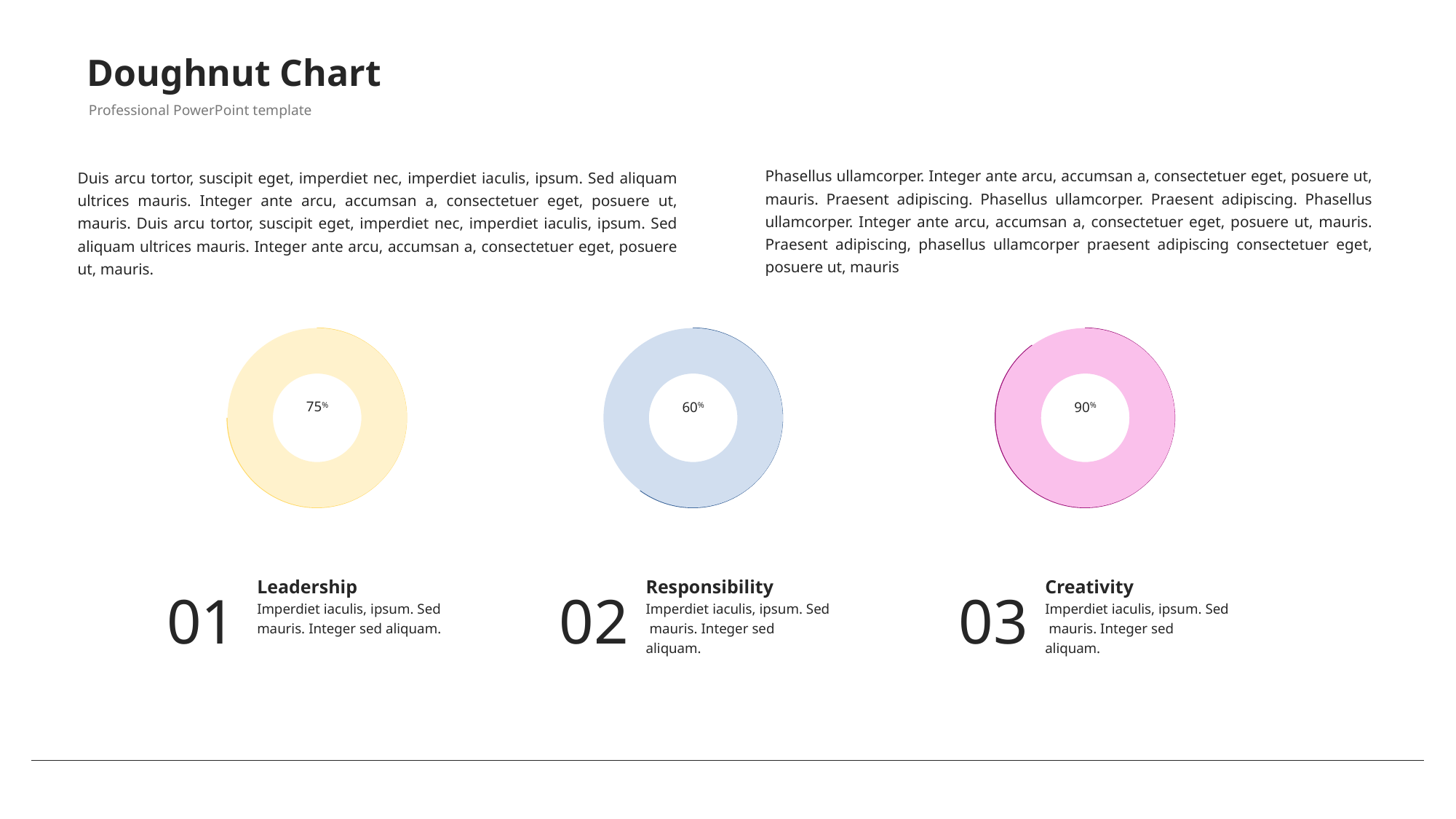
What value is shown in the centre of the left doughnut chart (Leadership)? 75% What value is shown in the centre of the right doughnut chart (Creativity)? 90% What is the difference between the percentage in the left doughnut chart (Leadership) and the middle doughnut chart (Responsibility)? 15% How many doughnut charts are on the slide? 3 What kind of chart is used on this slide? Doughnut chart Which of the three doughnut charts shows the highest percentage? Creativity (90%) What is the difference between the percentage in the right doughnut chart (Creativity) and the middle doughnut chart (Responsibility)? 30% What colour is the right doughnut chart (Creativity)? Pink What value is shown in the centre of the middle doughnut chart (Responsibility)? 60% Which is larger, the percentage in the left doughnut chart (Leadership) or the right doughnut chart (Creativity)? Creativity What is the title of the slide? Doughnut Chart Which of the three doughnut charts shows the lowest percentage? Responsibility (60%)